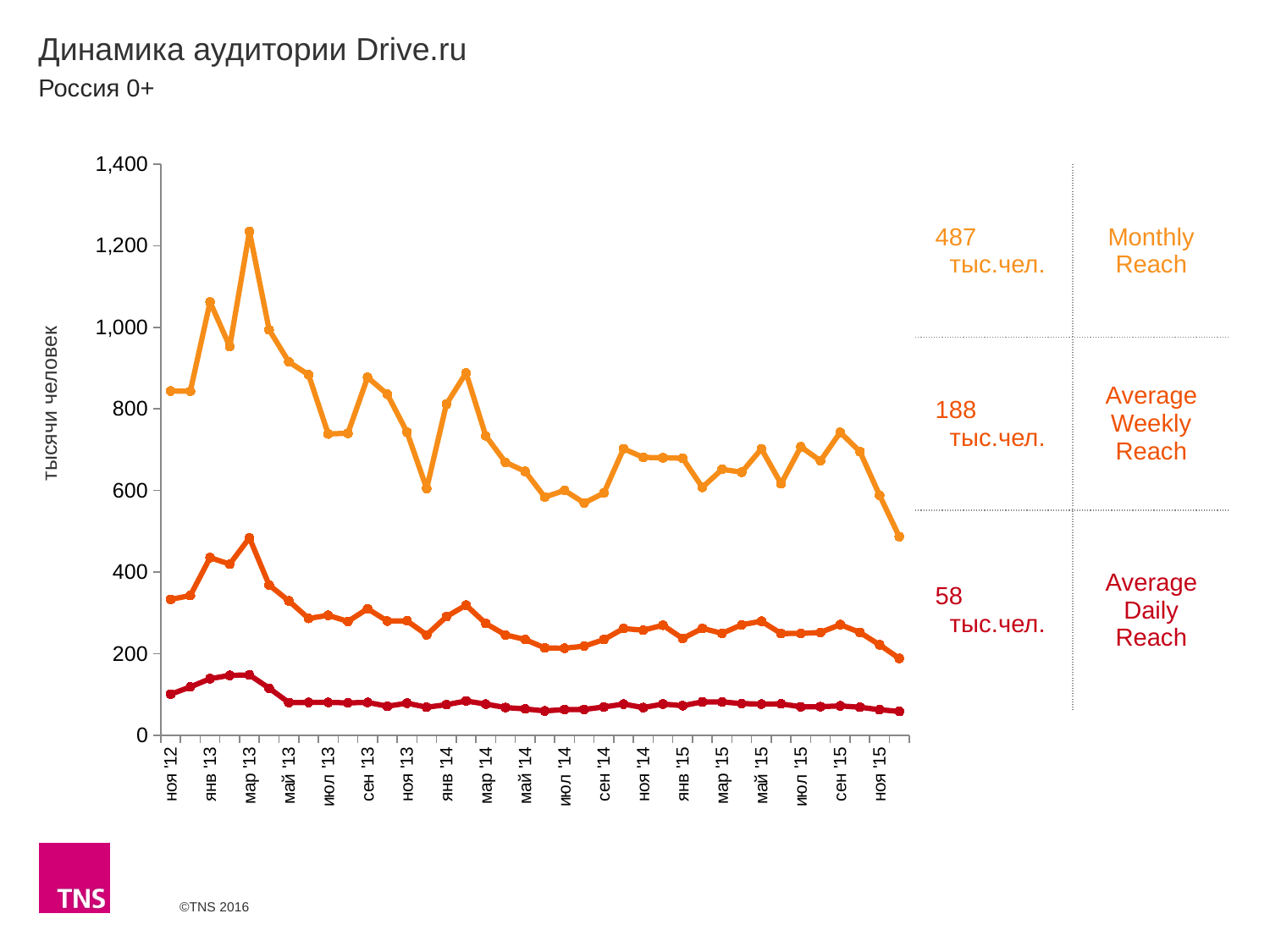
What is the latest Average Daily Reach value shown on the slide? 58 тыс.чел. How many series are plotted on the chart? 3 Which series has the lowest values throughout the chart? Average Daily Reach What is the difference between the latest Monthly Reach and the latest Average Weekly Reach values? 299 тыс.чел. What kind of chart is shown on the slide? line chart What is the label on the vertical axis of the chart? тысячи человек Does the Monthly Reach line rise or fall overall from мар '13 to the end of the chart? fall Is the Monthly Reach value at мар '13 greater or less than 1,000? greater What is the latest Monthly Reach value shown on the slide? 487 тыс.чел. Is the Average Daily Reach value at ноя '12 greater or less than 200? less What is the latest Average Weekly Reach value shown on the slide? 188 тыс.чел. Which series has the highest values throughout the chart? Monthly Reach